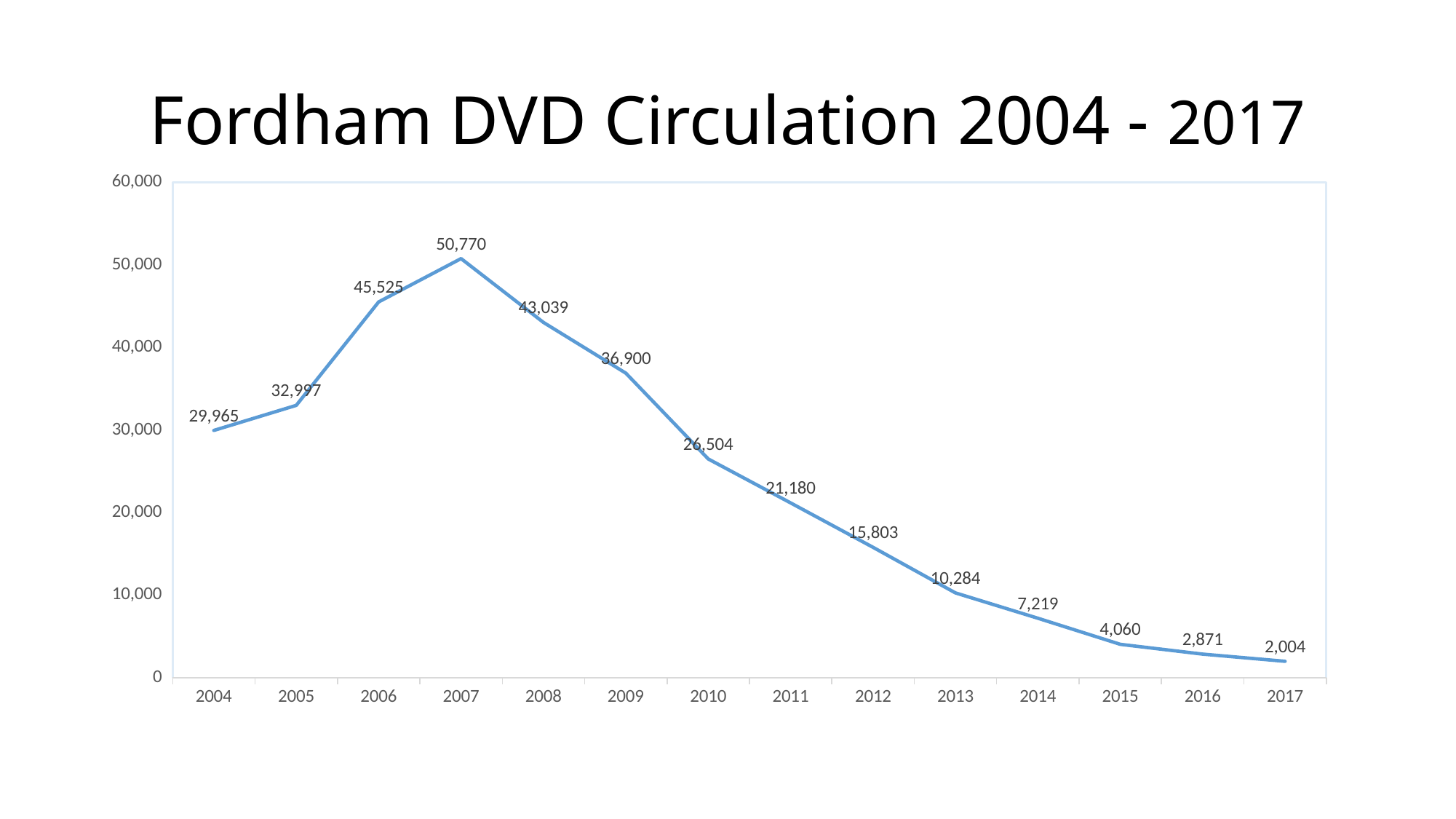
What kind of chart is shown on the slide? Line chart What was the DVD circulation in 2012? 15,803 Which year had the lowest DVD circulation? 2017 What was the DVD circulation in 2007? 50,770 Does DVD circulation rise or fall from 2007 to 2017? Fall What is the difference in DVD circulation between 2006 and 2005? 12,528 What was the DVD circulation in 2017? 2,004 What was the DVD circulation in 2004? 29,965 Which year had the highest DVD circulation? 2007 What is the difference in DVD circulation between 2007 and 2017? 48,766 Which year had higher DVD circulation, 2008 or 2010? 2008 How many years are plotted on the chart? 14